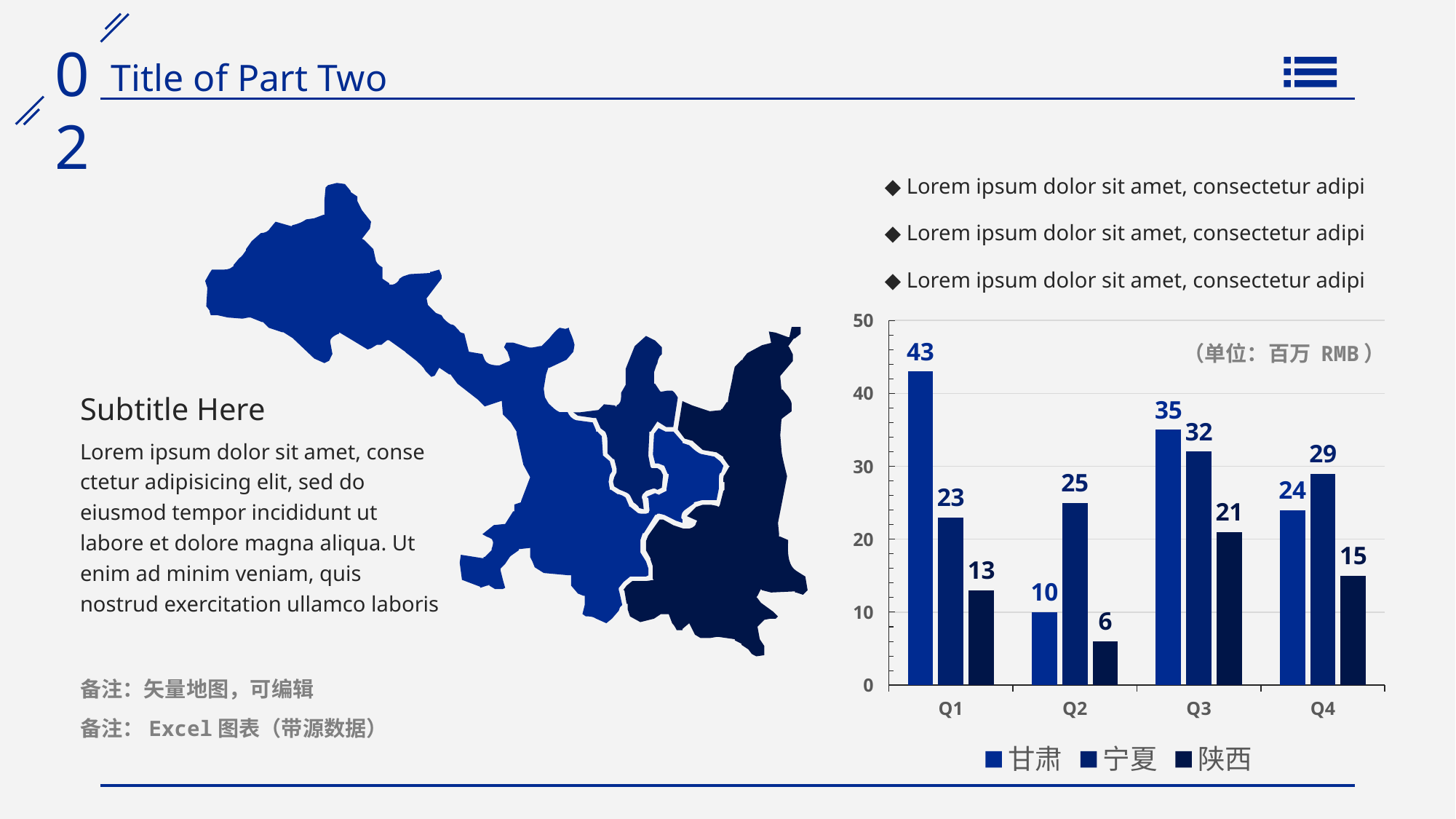
Which is larger in Q4, 甘肃 or 宁夏? 宁夏 In which quarter is the value for 甘肃 the lowest? Q2 How many series does the legend list? 3 What is the total of the three series in Q3? 88 How many quarters are shown on the x axis? 4 What is the value for 陕西 in Q2? 6 In which quarter is the value for 陕西 the highest? Q3 What is the value for 宁夏 in Q4? 29 What is the difference between 甘肃 and 宁夏 in Q1? 20 What kind of chart is shown on the slide? bar chart What unit is stated on the chart? 百万 RMB What is the value for 甘肃 in Q1? 43